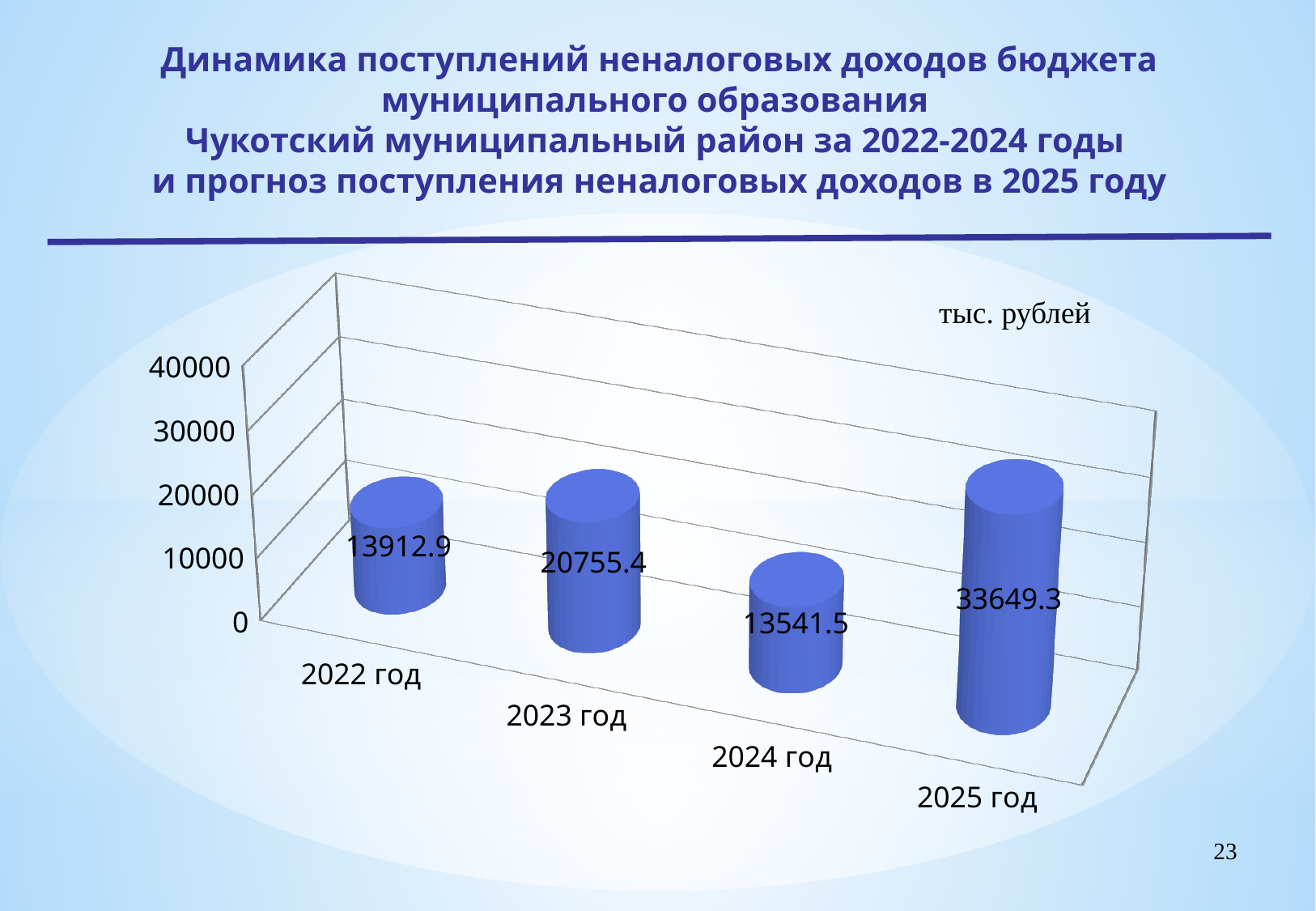
What kind of chart is shown on the slide? bar chart How many years are shown on the chart? 4 Which year has the highest value? 2025 год What is the forecast value for 2025 год? 33649.3 What is the difference between the values for 2023 год and 2022 год? 6842.5 Which is larger, the value for 2023 год or the value for 2025 год? 2025 год What is the difference between the values for 2025 год and 2024 год? 20107.8 Does the value rise or fall from 2023 год to 2024 год? fall Which year has the lowest value? 2024 год What is the value for 2022 год? 13912.9 What is the value for 2023 год? 20755.4 What is the value for 2024 год? 13541.5